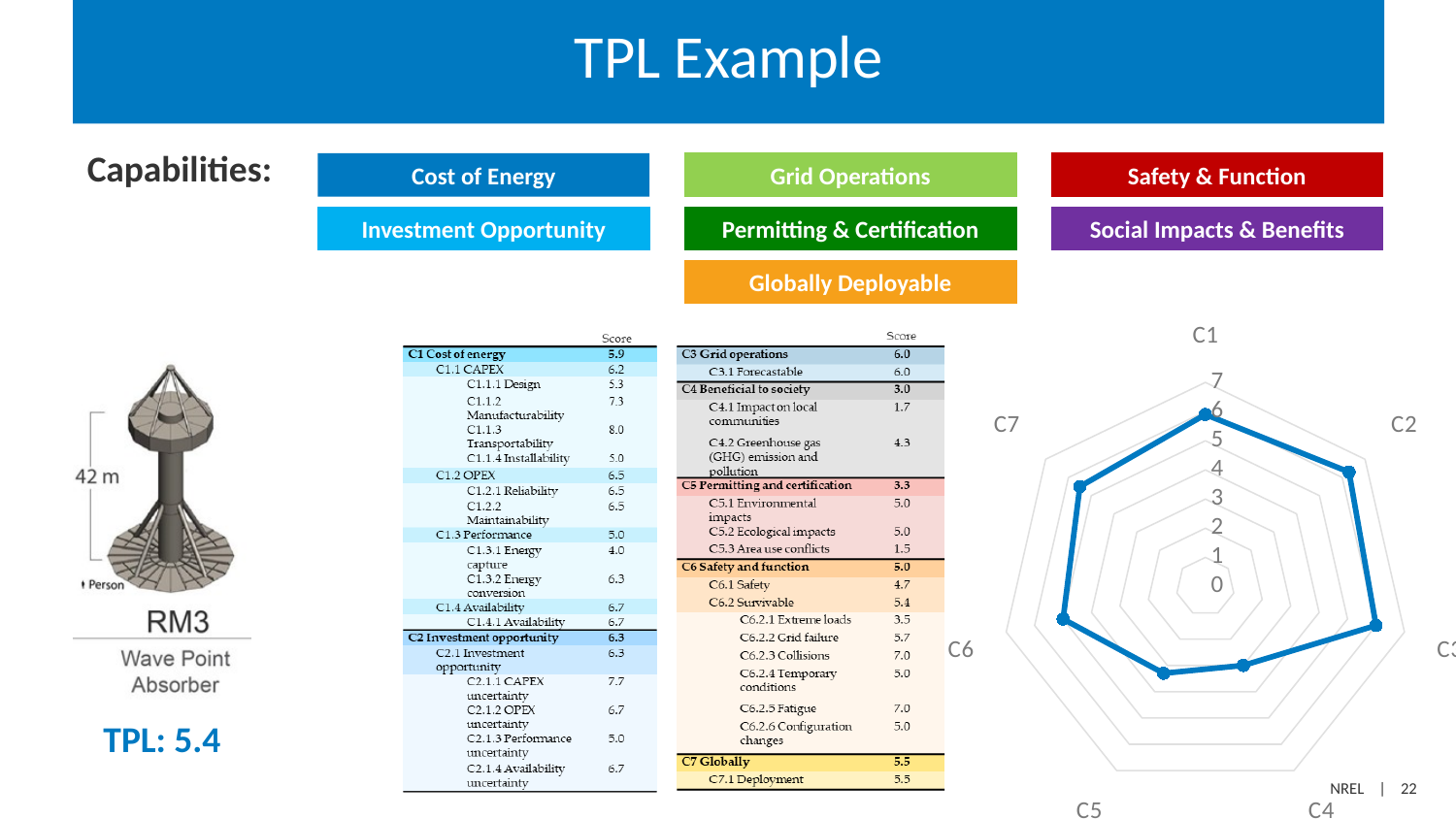
On the radar chart, is the value for C2 greater or less than 5? greater On the radar chart, is the value for C5 greater or less than 4? less On the radar chart, is the value for C6 greater or less than 4? greater What is the lowest tick value shown on the radar chart's scale? 0 What is the highest tick value shown on the radar chart's scale? 7 On the radar chart, which has the larger value, C2 or C5? C2 On the radar chart, which has the larger value, C1 or C4? C1 How many categories (axes) does the radar chart have? 7 What kind of chart is shown on the right side of the slide? radar chart